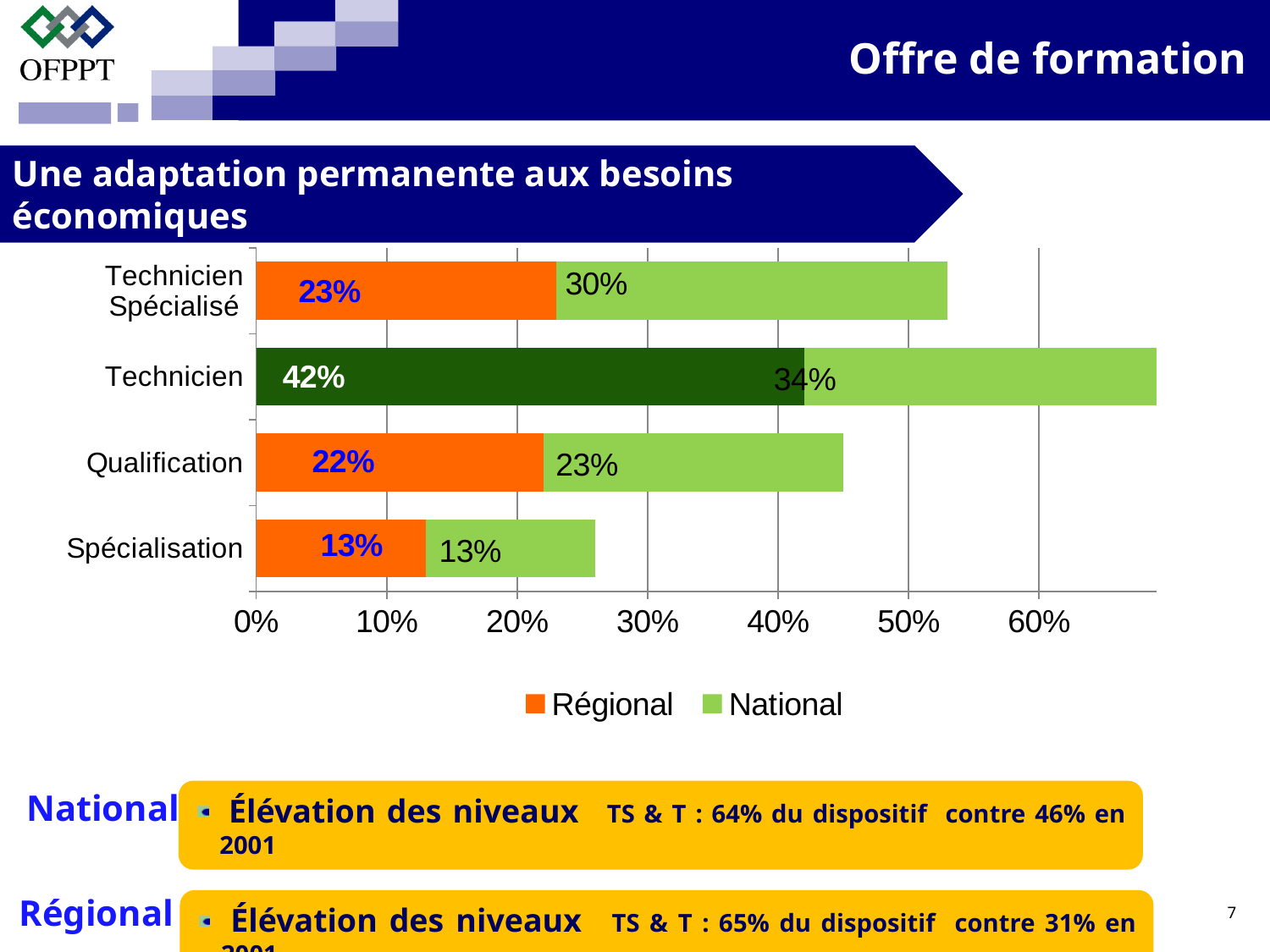
What is the Régional value for Spécialisation? 13% How many series does the legend list? 2 What kind of chart is shown on the slide? Stacked bar chart What is the total of the stacked bar for Technicien? 76% Which category has the lowest National value? Spécialisation What is the Régional value for Technicien? 42% What is the National value for Qualification? 23% What is the National value for Technicien Spécialisé? 30% What is the difference between the Régional and National values for Technicien? 8% How many categories are shown on the chart? 4 Which category has the highest Régional value? Technicien Which is larger for Technicien Spécialisé, the Régional value or the National value? National